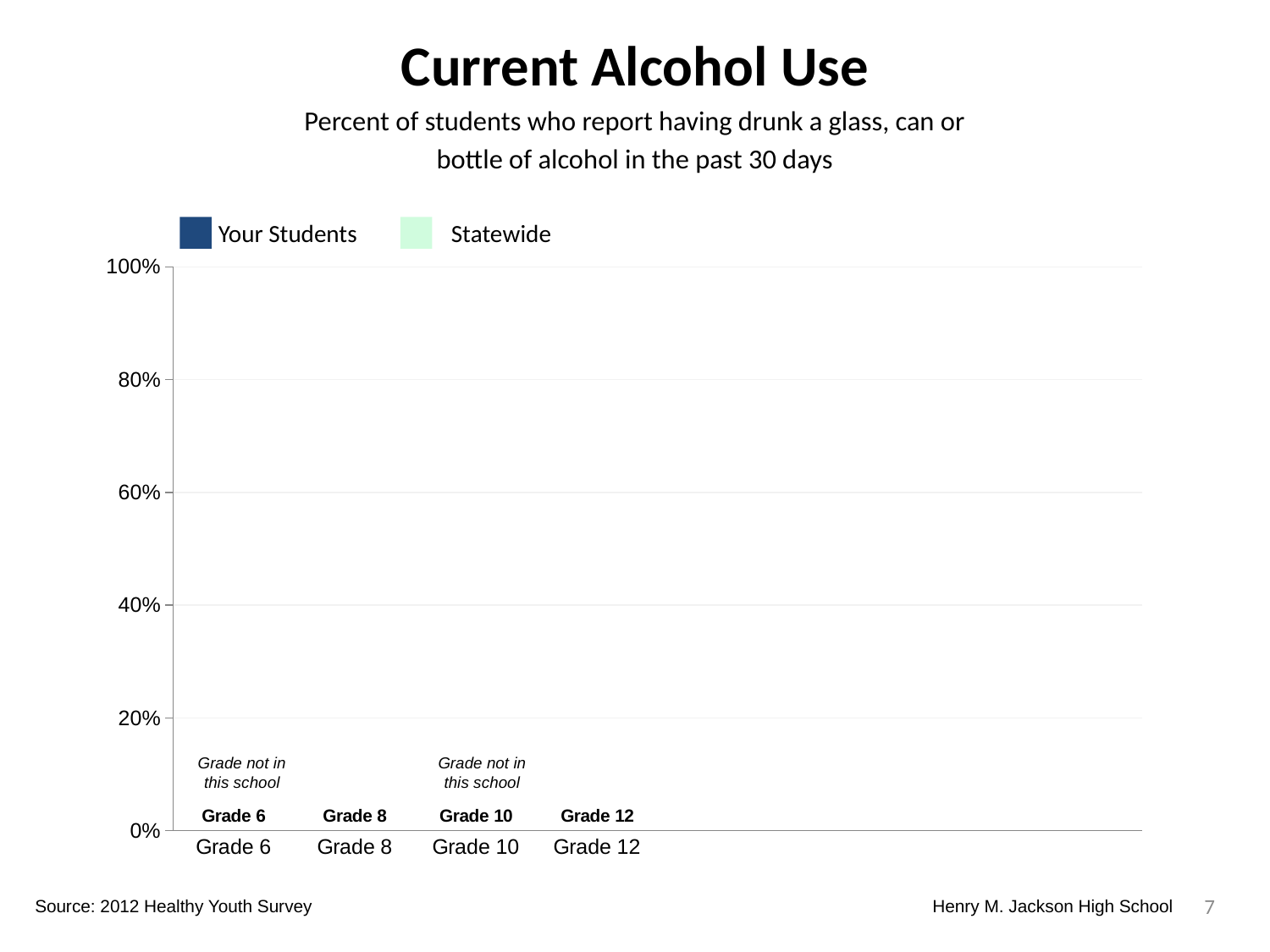
What is the title of the chart? Current Alcohol Use How many series does the legend list? 2 What is the highest value shown on the y axis? 100% Which grades are marked as 'Grade not in this school'? Grade 6 and Grade 10 What are the two series named in the legend? Your Students and Statewide How many grade categories are shown on the x axis? 4